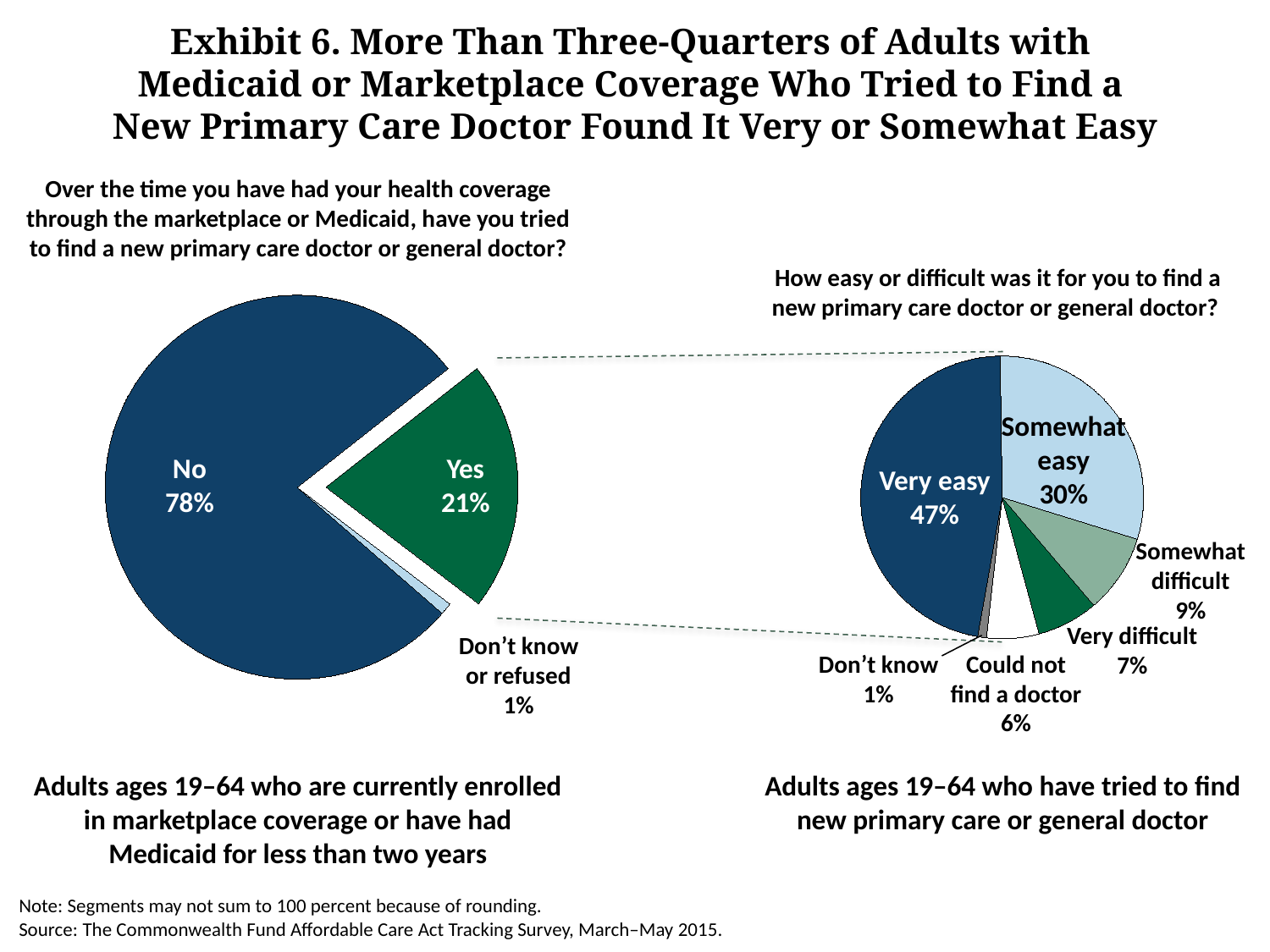
How many segments does the right pie chart have? 6 In the left pie chart, what is the difference in percentage points between 'No' and 'Yes'? 57 In the right pie chart, what percentage 'Could not find a doctor'? 6% In the left pie chart, what percentage of adults answered 'No' to having tried to find a new primary care doctor? 78% In the right pie chart, what is the difference in percentage points between 'Very easy' and 'Somewhat easy'? 17 In the right pie chart, which response has the largest share? Very easy In the right pie chart, what share of adults found it 'Very easy' to find a new primary care doctor? 47% In the left pie chart, what percentage of adults answered 'Yes'? 21% In the right pie chart, which is larger: 'Somewhat difficult' or 'Very difficult'? Somewhat difficult In the right pie chart, what percentage said it was 'Somewhat difficult'? 9% What type of chart is used on the left side of the slide? Pie chart In the right pie chart, which response has the smallest share? Don't know